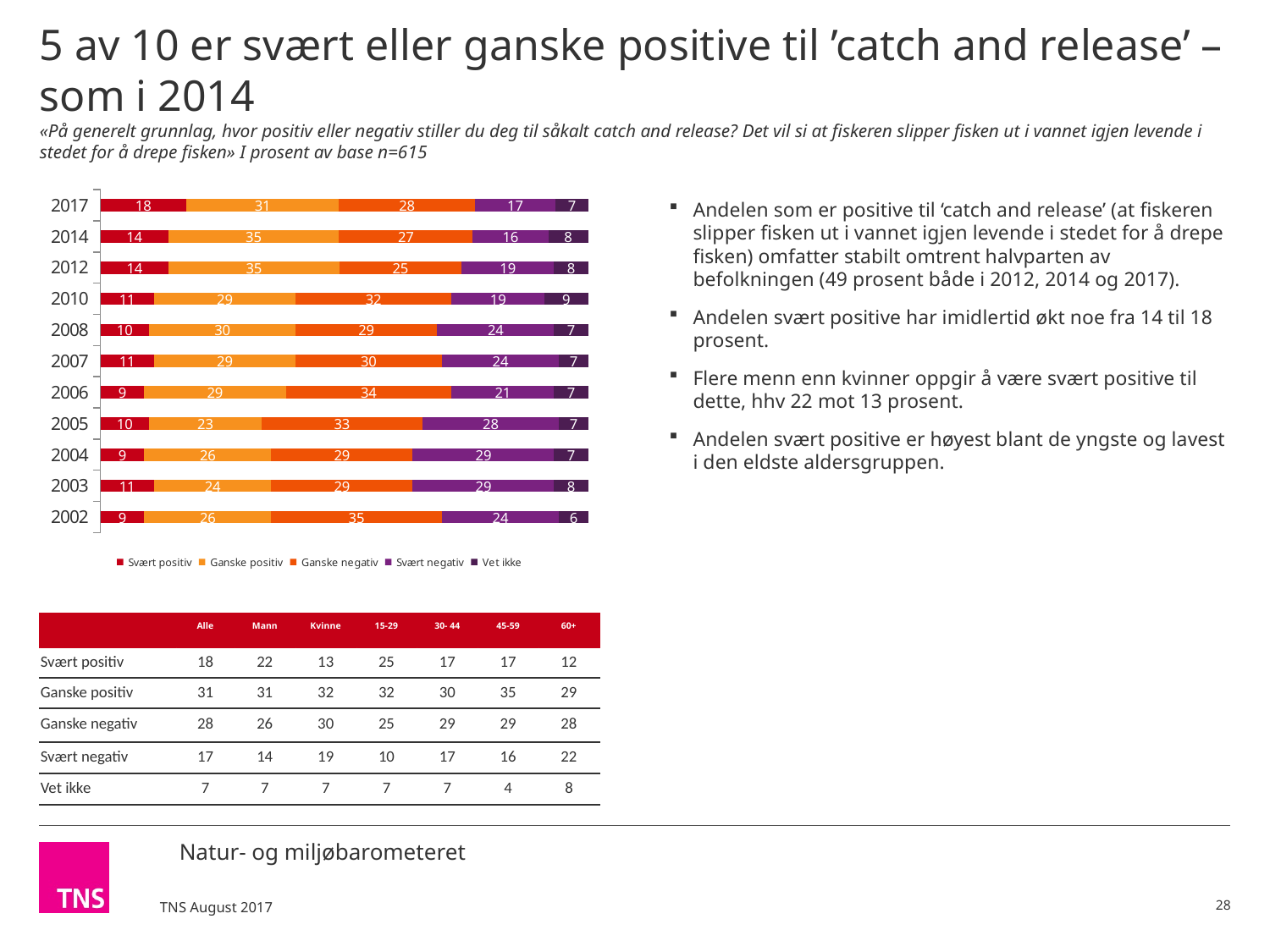
Which series is shown in red in the chart legend? Svært positiv What is the value for 'Ganske negativ' in 2010? 32 In which year is the 'Vet ikke' value lowest? 2002 What type of chart is shown on the slide? Stacked bar chart How many series does the chart legend list? 5 What is the difference between the 'Svært positiv' values for 2017 and 2014? 4 What is the value for 'Svært positiv' in 2017? 18 What is the value for 'Svært negativ' in 2005? 28 How many years (categories) are shown in the chart? 11 What is the total of the stacked bar for 2014? 100 In which year is the 'Svært positiv' value highest? 2017 Which is larger, the 'Ganske positiv' value in 2014 or in 2017? 2014